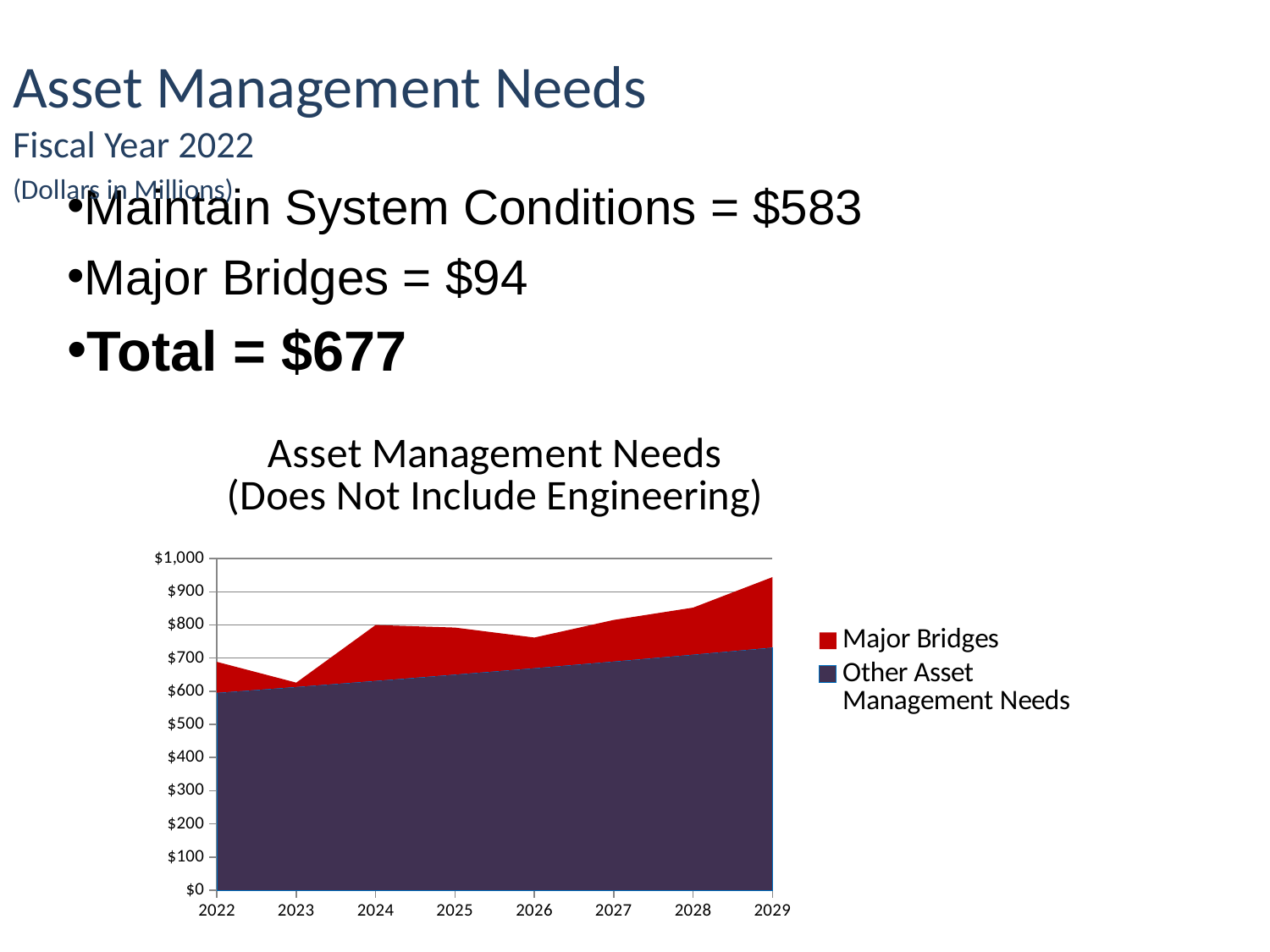
What is the title of the chart? Asset Management Needs (Does Not Include Engineering) How many years are plotted along the x axis of the chart? 8 How many series does the chart legend list? 2 Is the total stacked value for 2029 greater or less than $900? greater Is the total stacked value for 2023 greater or less than $700? less Which series is shown in red in the chart? Major Bridges What kind of chart is shown on the slide? Stacked area chart In which year is the total stacked value highest? 2029 Is the value for Other Asset Management Needs in 2029 greater or less than $700? greater Is the total stacked value larger in 2029 or in 2022? 2029 In which year is the total stacked value lowest? 2023 Does the Other Asset Management Needs series rise or fall from 2022 to 2029? rise